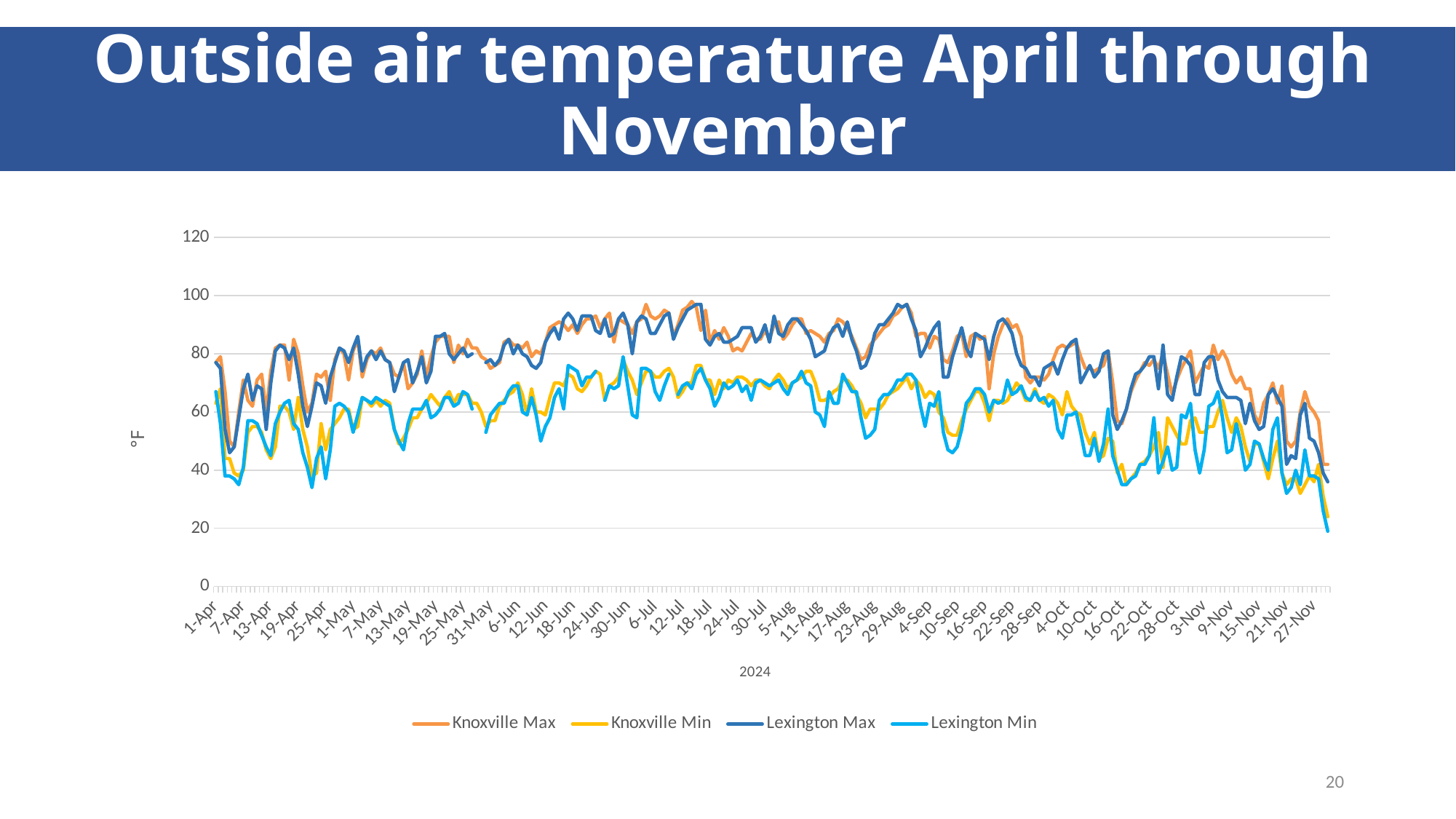
Is the Knoxville Max value around 12-Jul greater or less than 80? greater What unit is shown on the vertical axis label? °F How many series does the legend list? 4 Is the Knoxville Min value around 12-Jul greater or less than 60? greater Is the Lexington Max value on 1-Apr greater or less than 60? greater What kind of chart is shown on the slide? Line chart Do the Knoxville Max values generally rise or fall from 29-Aug to 27-Nov? fall Around 12-Jul, which is larger: Lexington Max or Lexington Min? Lexington Max Do the Lexington Max values generally rise or fall from 1-Apr to 12-Jul? rise What is the title of the chart on the slide? Outside air temperature April through November